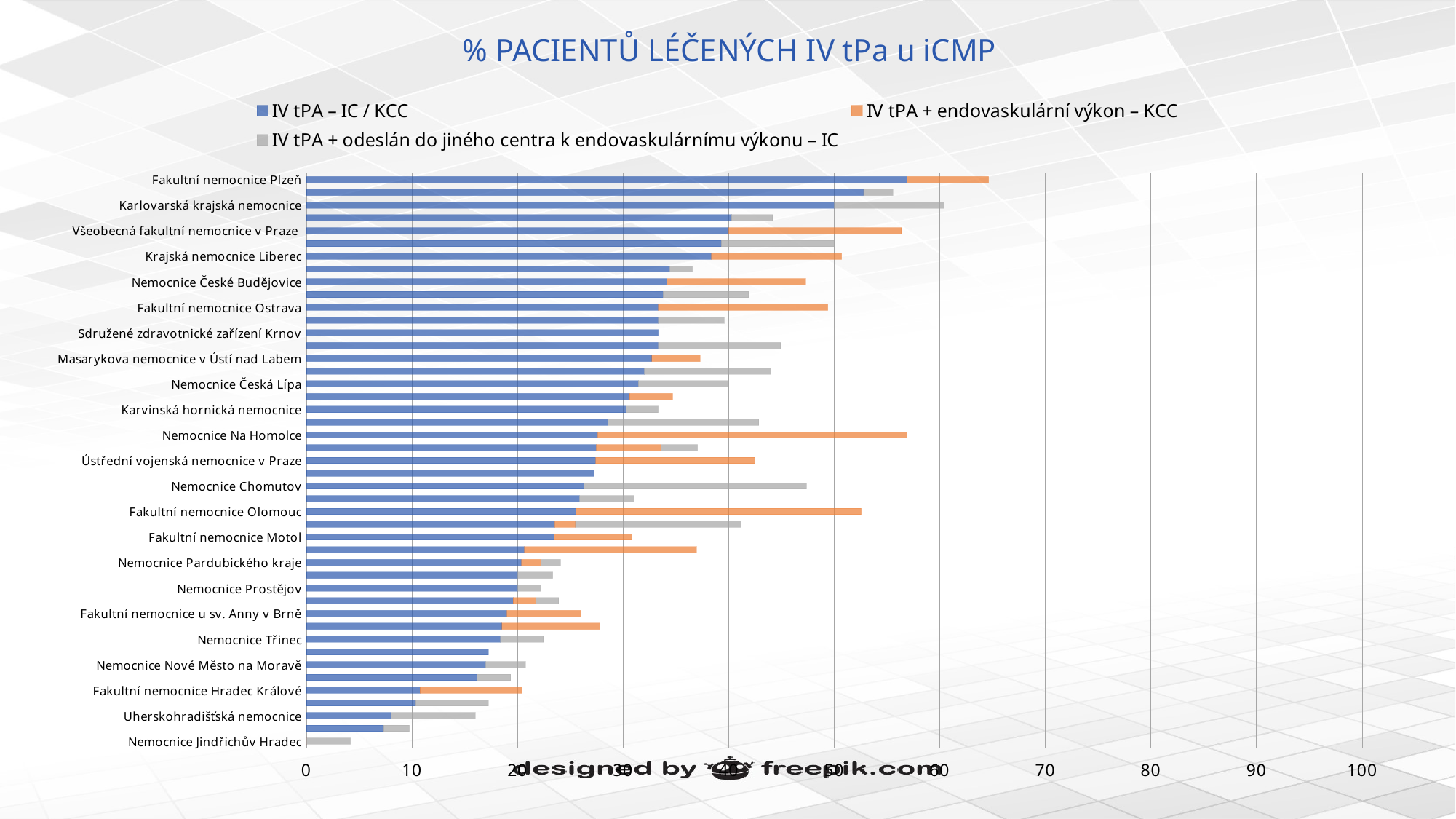
Is the total bar for Fakultní nemocnice Plzeň greater or less than 60? greater Which has the larger IV tPA – IC / KCC value: Fakultní nemocnice Plzeň or Fakultní nemocnice Hradec Králové? Fakultní nemocnice Plzeň Is the IV tPA – IC / KCC value for Fakultní nemocnice Hradec Králové greater or less than 20? less Is the total bar for Nemocnice Na Homolce greater or less than 50? greater Which labelled hospital has the longest total bar? Fakultní nemocnice Plzeň What kind of chart is shown on the slide? bar chart Which labelled hospital has the shortest total bar? Nemocnice Jindřichův Hradec What is the title of the chart? % PACIENTŮ LÉČENÝCH IV tPa u iCMP Which series is shown in orange in the legend? IV tPA + endovaskulární výkon – KCC Which has the longer total bar: Fakultní nemocnice Ostrava or Fakultní nemocnice Motol? Fakultní nemocnice Ostrava How many series does the legend list? 3